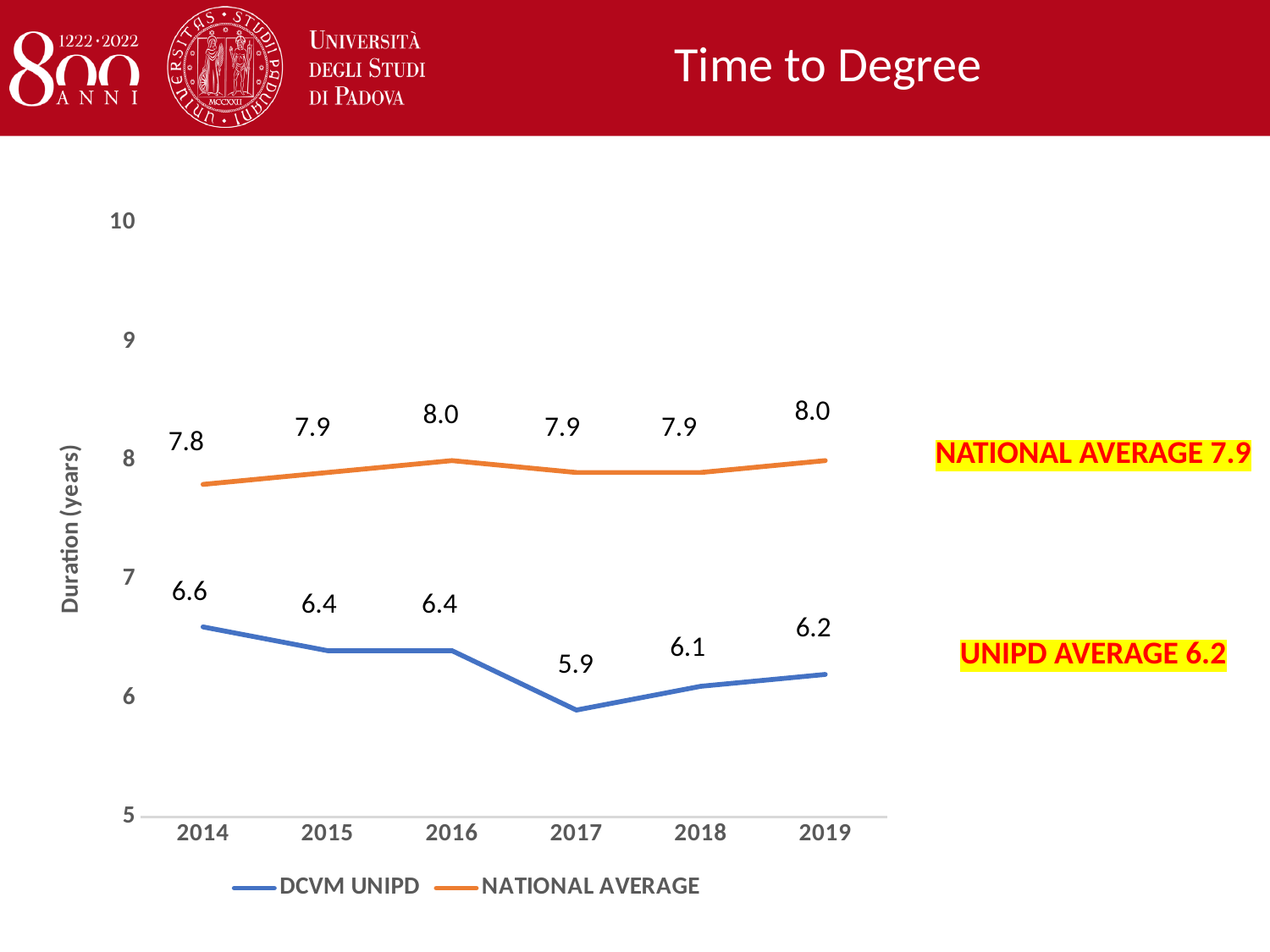
Is the DCVM UNIPD value for 2014 greater or less than 7? less How many series does the legend list? 2 What is the label of the vertical axis? Duration (years) How many years are shown on the x axis? 6 In which year is the DCVM UNIPD time to degree highest? 2014 What is the NATIONAL AVERAGE time to degree in 2014? 7.8 In which year is the DCVM UNIPD time to degree lowest? 2017 What kind of chart is shown on the slide? line chart What is the DCVM UNIPD time to degree in 2017? 5.9 Which is larger in 2016, the DCVM UNIPD value or the NATIONAL AVERAGE value? NATIONAL AVERAGE What is the difference between the NATIONAL AVERAGE and DCVM UNIPD values in 2017? 2.0 What is the DCVM UNIPD value in 2019? 6.2